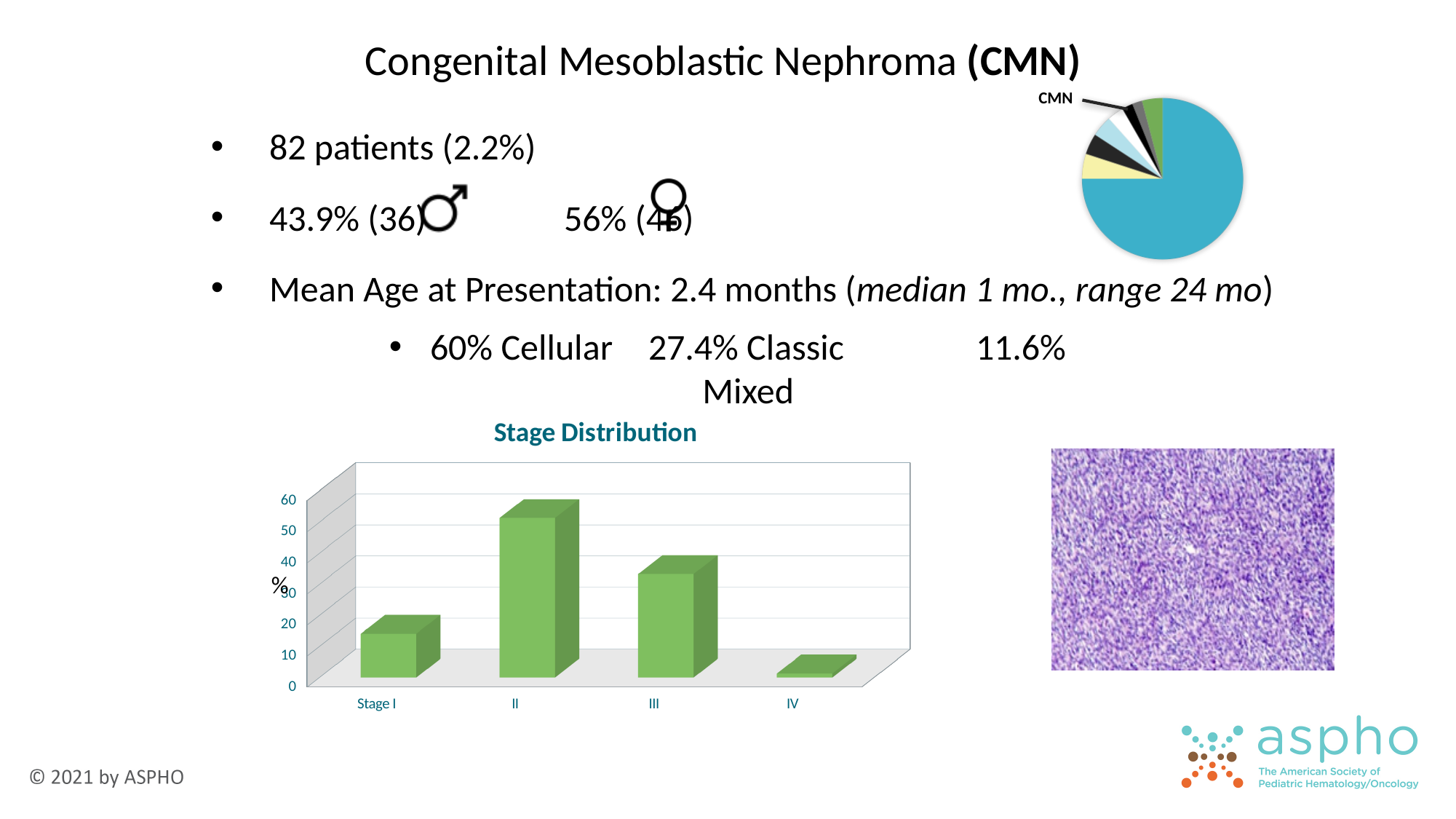
In the "Stage Distribution" chart, is the value for Stage II greater or less than 40? greater What is the title of the bar chart on the slide? Stage Distribution In the "Stage Distribution" chart, is the value for Stage IV greater or less than 10? less What kind of chart is the chart in the top right corner of the slide? pie chart In the "Stage Distribution" chart, which stage has the lowest value? IV What kind of chart is the "Stage Distribution" chart? bar chart In the "Stage Distribution" chart, which stage has the highest value? II In the "Stage Distribution" chart, is the value for Stage I greater or less than 20? less In the "Stage Distribution" chart, which is larger, the value for Stage II or the value for Stage III? Stage II In the "Stage Distribution" chart, which is larger, the value for Stage III or the value for Stage I? Stage III How many stage categories are shown in the "Stage Distribution" chart? 4